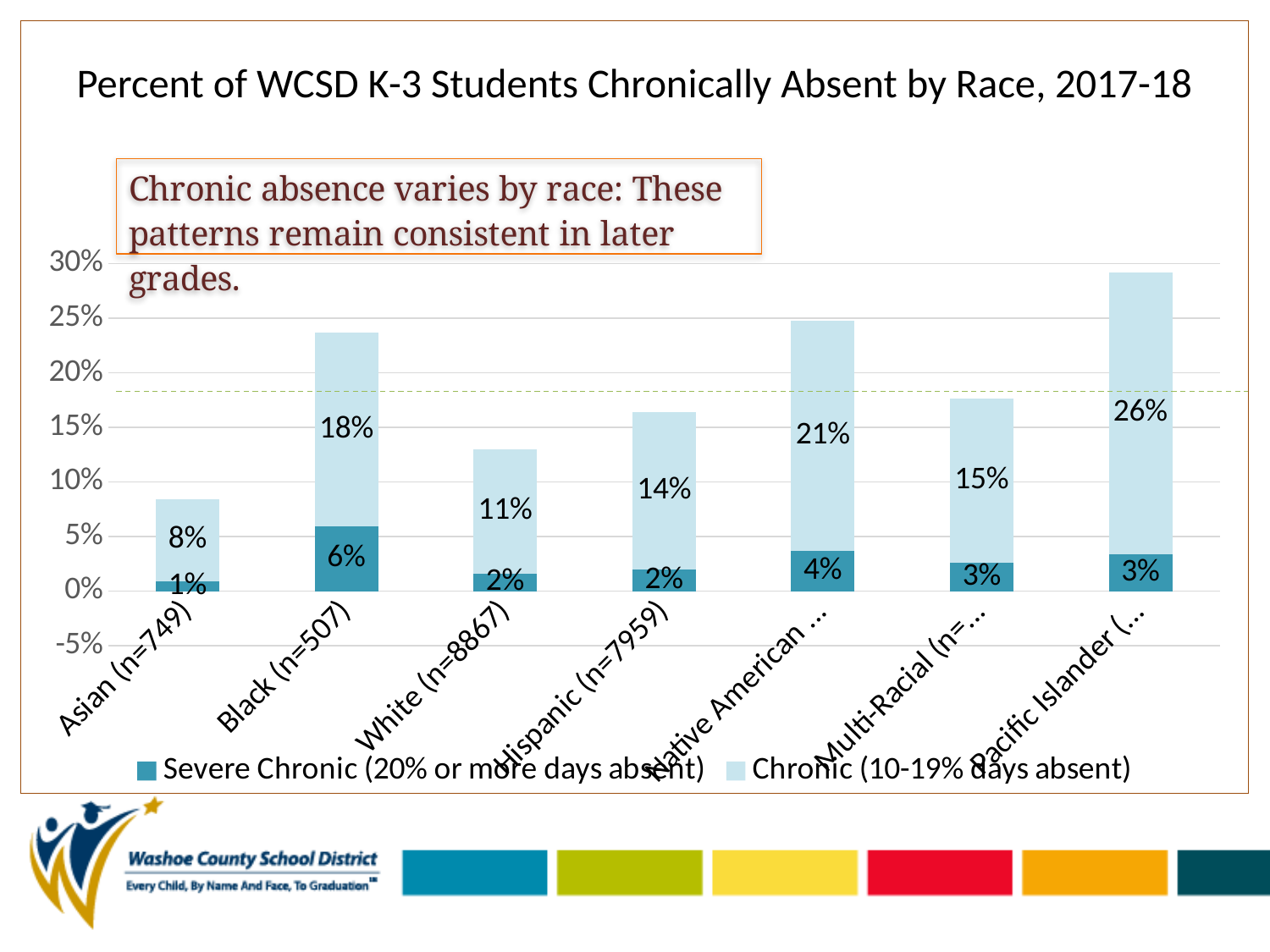
How many series does the legend list? 2 What is the total stacked value for Pacific Islander students? 29% What is the Chronic (10-19% days absent) value for Pacific Islander students? 26% What kind of chart is shown on the slide? Stacked bar chart What is the Chronic (10-19% days absent) value for Black (n=507)? 18% How many race categories are shown on the x axis? 7 What is the total stacked value for Asian (n=749) students? 9% Which race category has the lowest Severe Chronic (20% or more days absent) value? Asian (n=749) Which race category has the highest Chronic (10-19% days absent) value? Pacific Islander What is the Severe Chronic (20% or more days absent) value for Native American students? 4% What is the difference between the Chronic (10-19% days absent) values for Native American and White (n=8867) students? 10% Which is larger, the Severe Chronic value for Black (n=507) or for Hispanic (n=7959)? Black (n=507)